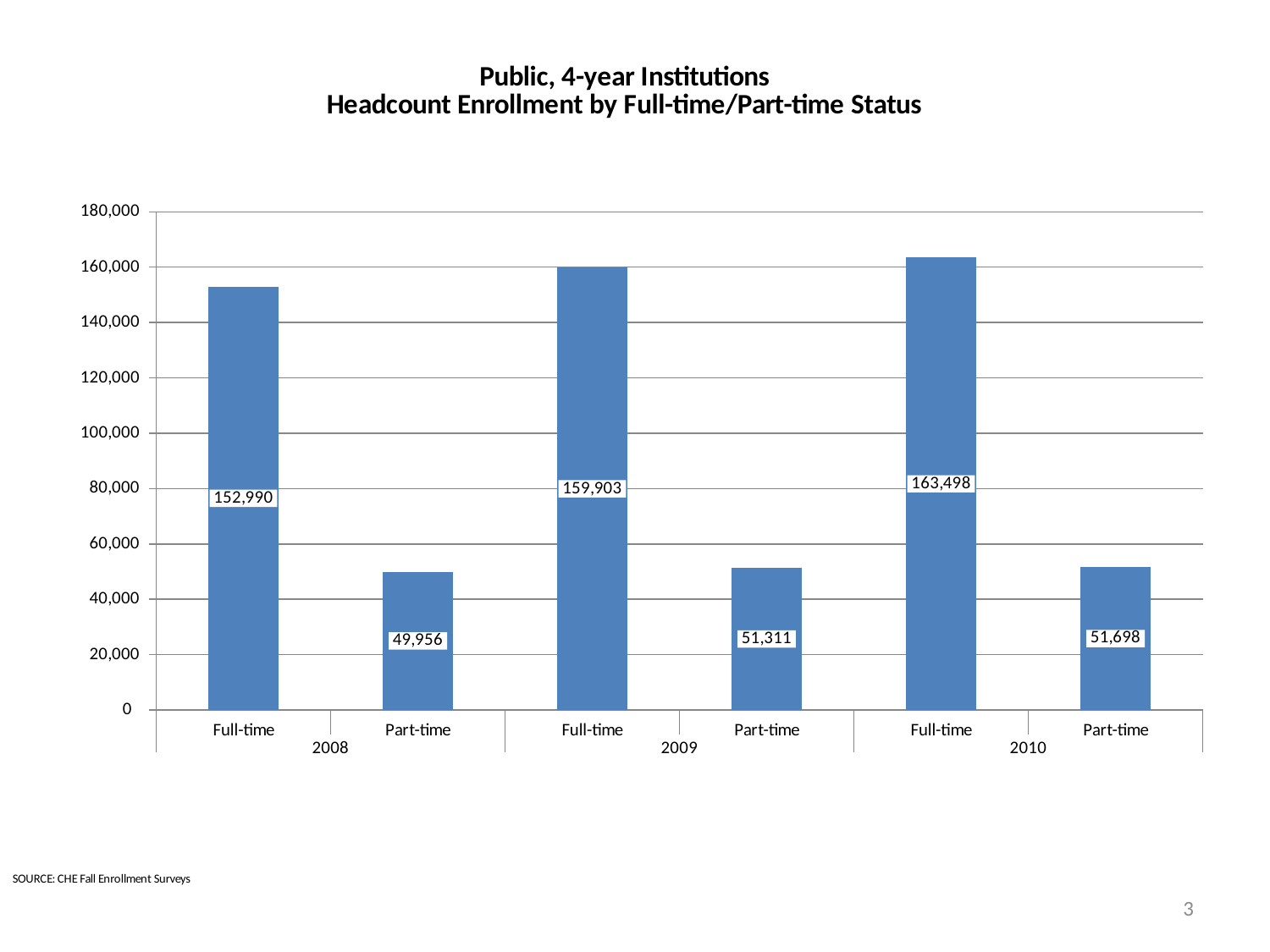
Which bar has the lowest value? Part-time 2008 What type of chart is shown on the slide? Bar chart What is the Full-time headcount enrollment for 2010? 163,498 How many bars are plotted on the chart? 6 Is the Full-time value for 2009 greater or less than 140,000? greater What is the Part-time headcount enrollment for 2009? 51,311 What is the difference between Full-time enrollment in 2010 and Full-time enrollment in 2008? 10,508 What is the Full-time headcount enrollment for 2008? 152,990 Which is larger, Full-time enrollment in 2009 or Full-time enrollment in 2008? Full-time enrollment in 2009 What is the Part-time headcount enrollment for 2008? 49,956 What is the difference between Part-time enrollment in 2010 and Part-time enrollment in 2009? 387 Which bar has the highest value? Full-time 2010